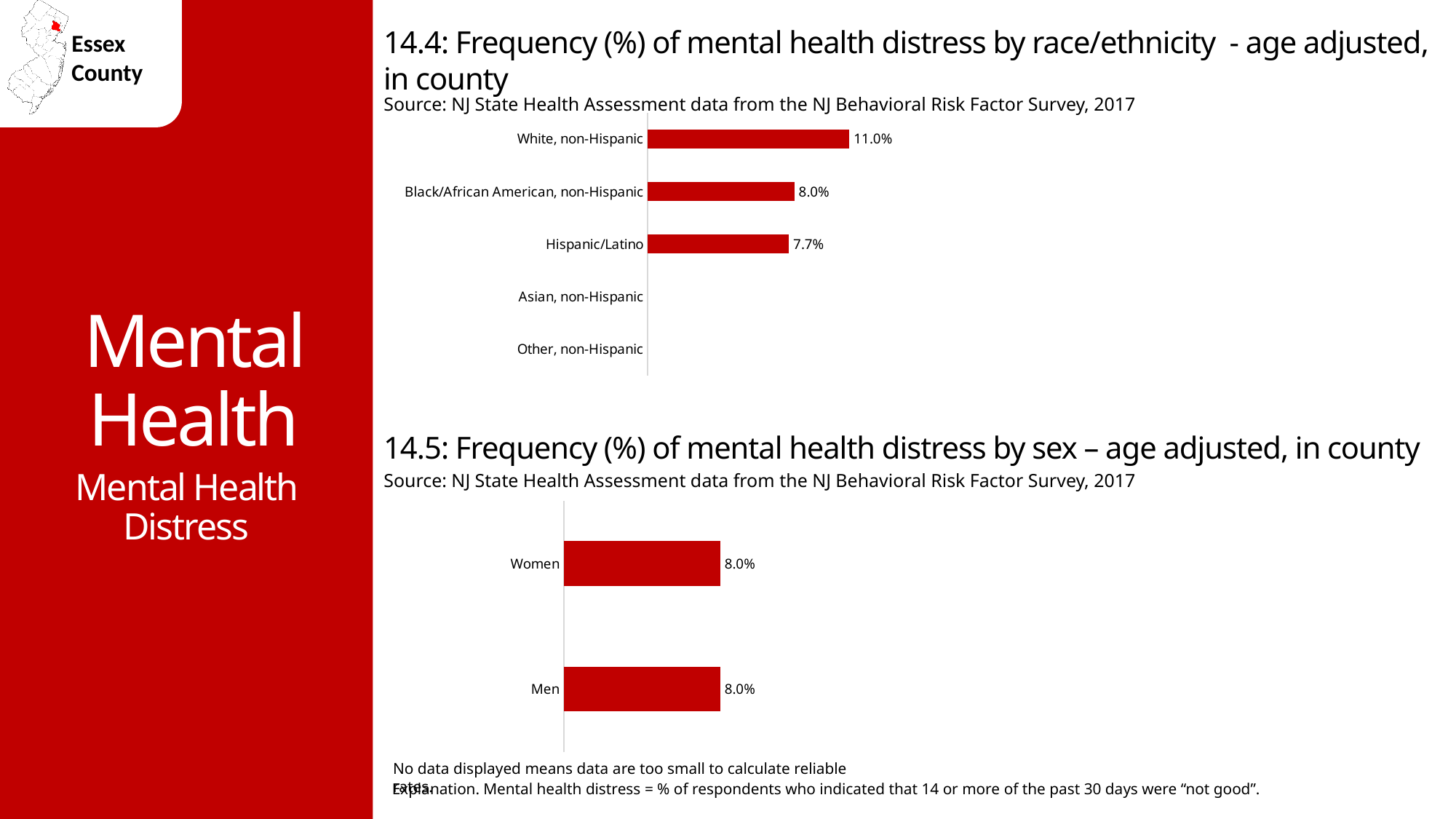
In the chart '14.4: Frequency (%) of mental health distress by race/ethnicity', what is the difference between the values for White, non-Hispanic and Hispanic/Latino? 3.3% What kind of chart is '14.5: Frequency (%) of mental health distress by sex'? Bar chart In the chart '14.4: Frequency (%) of mental health distress by race/ethnicity', what is the value for Black/African American, non-Hispanic? 8.0% In the chart '14.4: Frequency (%) of mental health distress by race/ethnicity', which category has the highest value? White, non-Hispanic In the chart '14.5: Frequency (%) of mental health distress by sex', what is the value for Men? 8.0% In the chart '14.4: Frequency (%) of mental health distress by race/ethnicity', how many race/ethnicity categories are listed on the axis? 5 In the chart '14.4: Frequency (%) of mental health distress by race/ethnicity', which is larger, the value for Black/African American, non-Hispanic or the value for Hispanic/Latino? Black/African American, non-Hispanic In the chart '14.5: Frequency (%) of mental health distress by sex', what is the difference between the values for Women and Men? 0.0% In the chart '14.4: Frequency (%) of mental health distress by race/ethnicity', which categories have no bar displayed? Asian, non-Hispanic and Other, non-Hispanic In the chart '14.5: Frequency (%) of mental health distress by sex', what is the value for Women? 8.0% In the chart '14.4: Frequency (%) of mental health distress by race/ethnicity', what is the value for White, non-Hispanic? 11.0% In the chart '14.4: Frequency (%) of mental health distress by race/ethnicity', what is the value for Hispanic/Latino? 7.7%